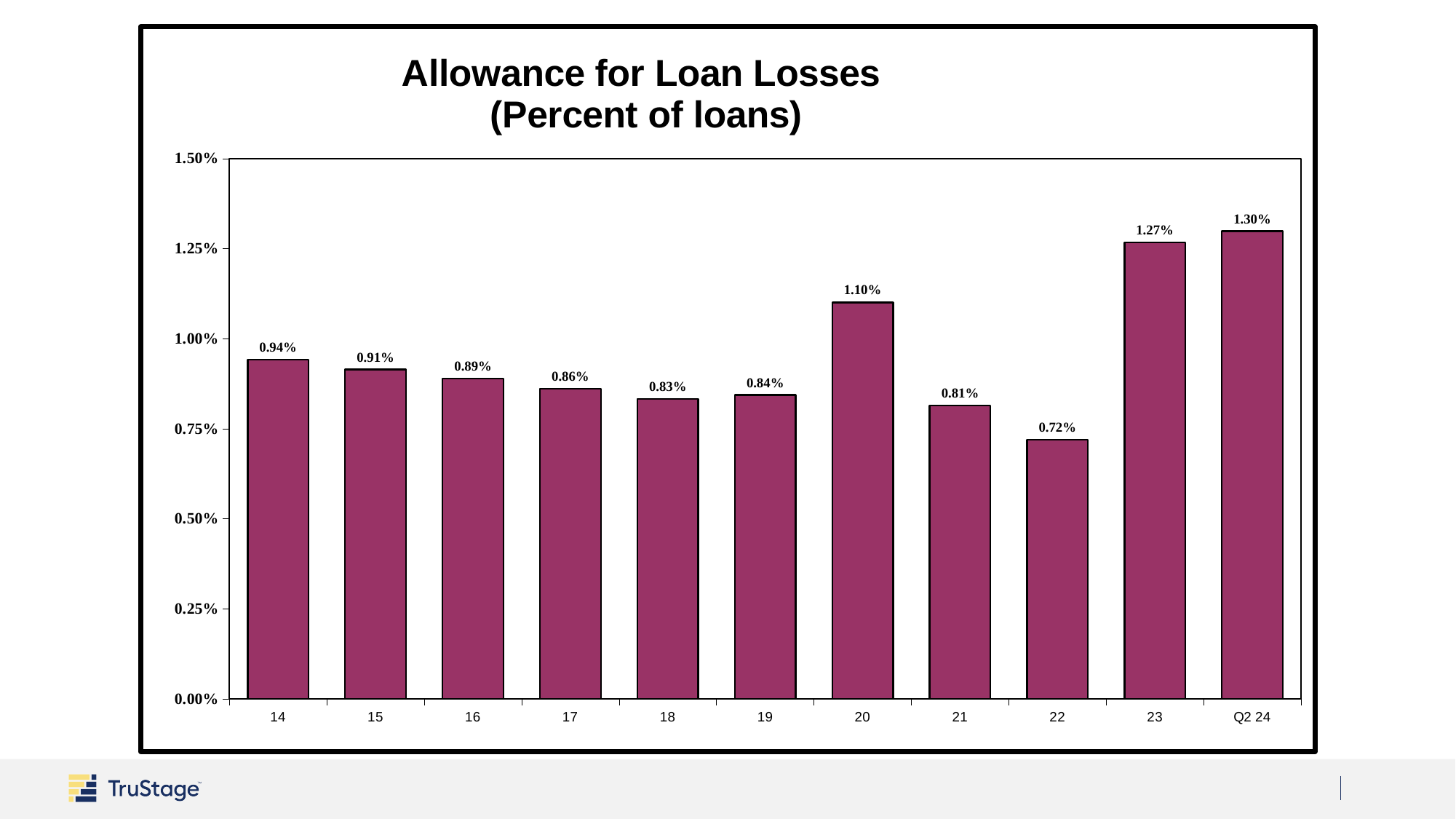
Do the values rise or fall from 14 to 18? fall Is the value for 21 greater or less than 1.00%? less Which is larger, the value for 14 or the value for 15? 14 What is the value shown for 18? 0.83% How many categories are shown on the x axis? 11 Which category has the highest allowance for loan losses? Q2 24 What is the difference between the values for 23 and 22? 0.55% What is the title of the chart? Allowance for Loan Losses (Percent of loans) Which category has the lowest allowance for loan losses? 22 What is the value shown for Q2 24? 1.30% What kind of chart is shown on the slide? bar chart What is the allowance for loan losses as a percent of loans in 20? 1.10%